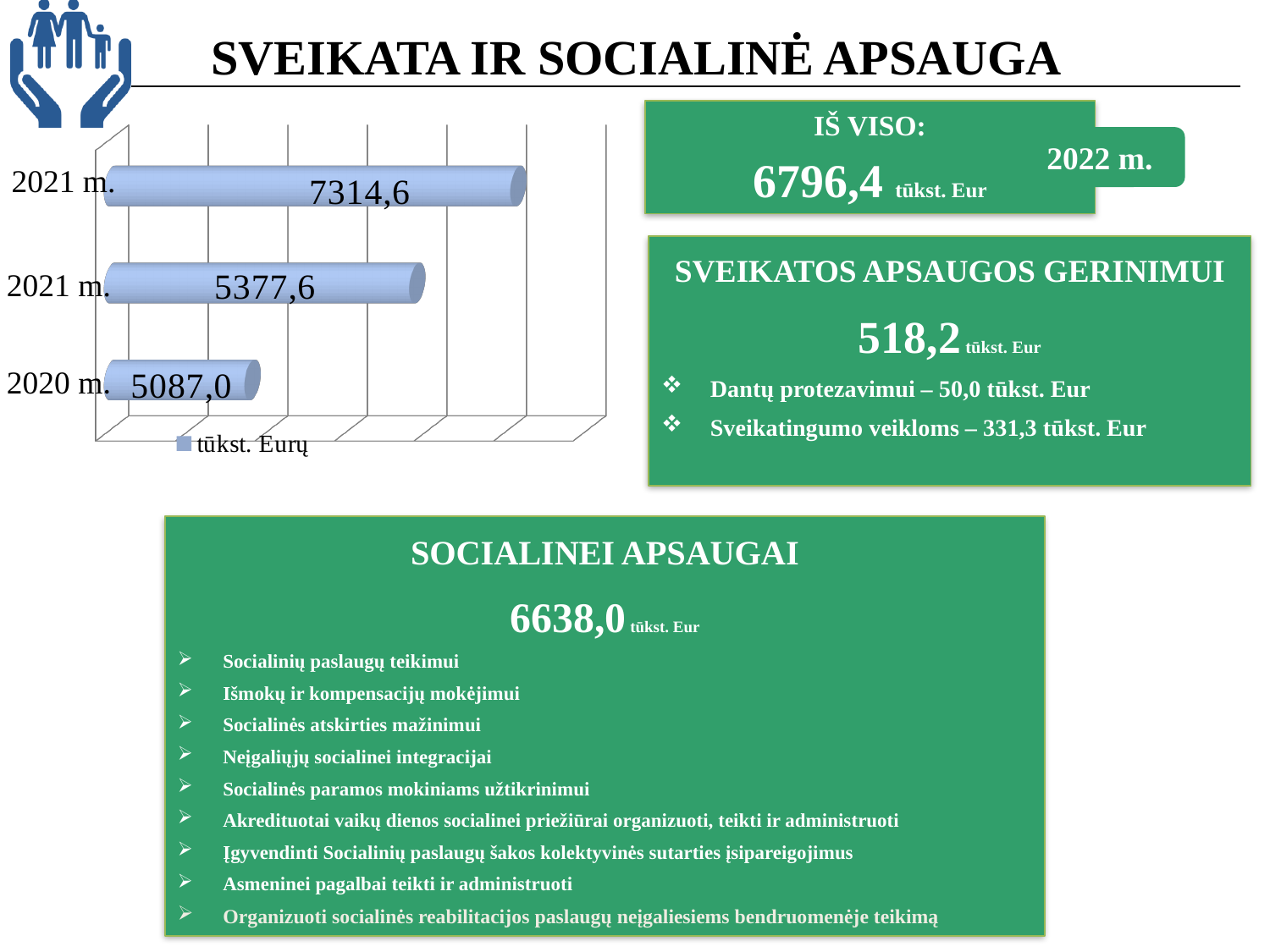
What is the value of the middle bar in the chart? 5377,6 What is the highest value shown in the chart? 7314,6 How many bars does the chart on the left show? 3 What is the value of the top bar in the chart? 7314,6 What is the legend entry shown below the chart? tūkst. Eurų Which category has the lowest value in the chart? 2020 m. What is the difference between the middle bar (5377,6) and the bar for 2020 m. (5087,0) in the chart? 290,6 What is the difference between the top bar (7314,6) and the bar for 2020 m. (5087,0) in the chart? 2227,6 What kind of chart is shown on the left of the slide? bar chart What is the value of the bar labelled 2020 m. in the chart? 5087,0 Which is larger in the chart: the middle bar or the bar for 2020 m.? the middle bar How many series does the legend of the chart list? 1